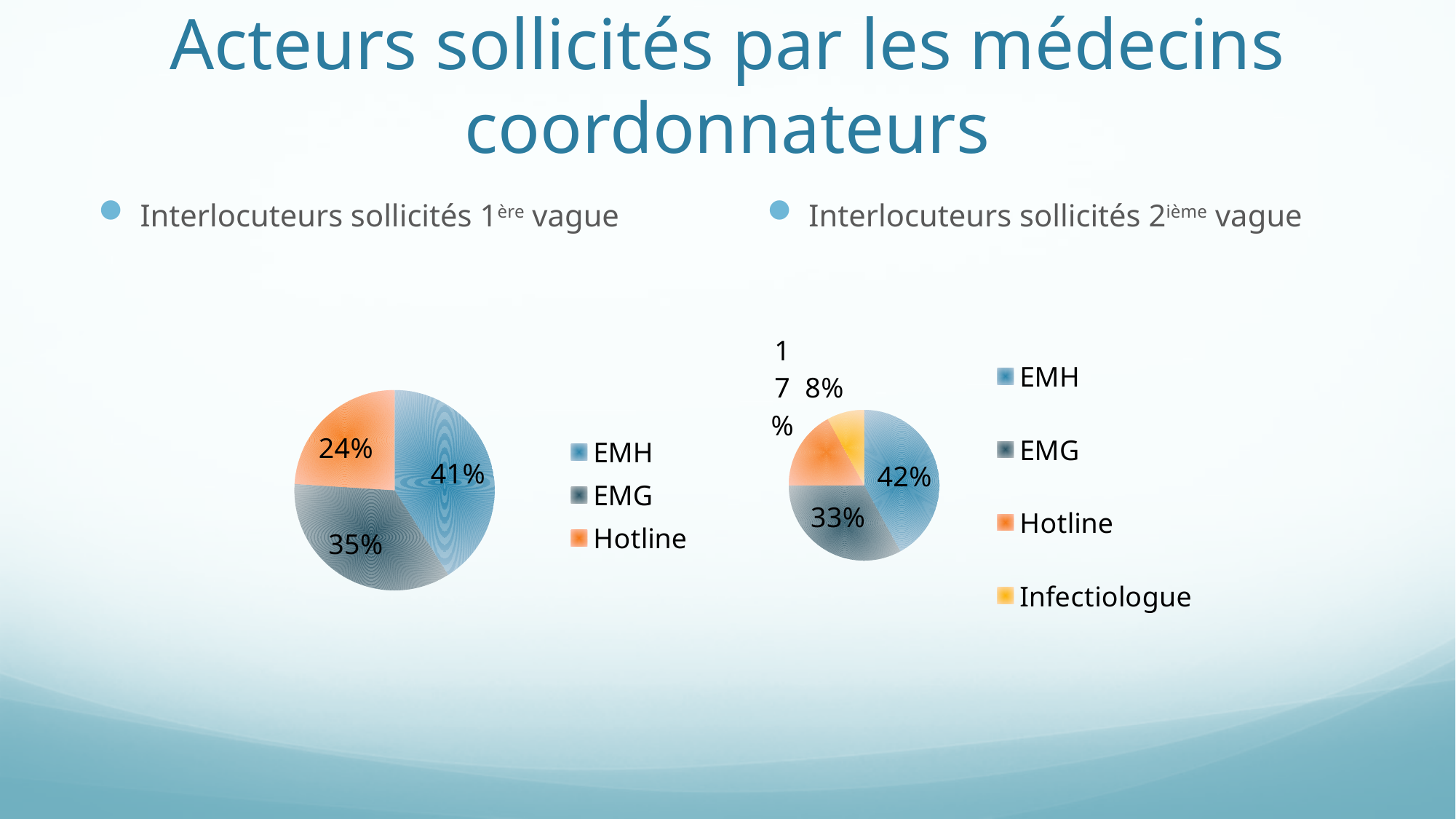
How many categories does the left pie chart (Interlocuteurs sollicités 1ère vague) show? 3 In the right pie chart (Interlocuteurs sollicités 2ième vague), what share does Infectiologue have? 8% In the right pie chart (Interlocuteurs sollicités 2ième vague), which category has the smallest share? Infectiologue In the right pie chart (Interlocuteurs sollicités 2ième vague), which is larger, the EMH share or the EMG share? EMH In the left pie chart (Interlocuteurs sollicités 1ère vague), which category has the largest share? EMH How many categories does the legend of the right pie chart (Interlocuteurs sollicités 2ième vague) list? 4 In the right pie chart (Interlocuteurs sollicités 2ième vague), what share does EMG have? 33% In the left pie chart (Interlocuteurs sollicités 1ère vague), what share does Hotline have? 24% In the left pie chart (Interlocuteurs sollicités 1ère vague), which category has the smallest share? Hotline What type of chart is used on the left side of the slide (Interlocuteurs sollicités 1ère vague)? Pie chart In the left pie chart (Interlocuteurs sollicités 1ère vague), what share does EMH have? 41% In the left pie chart (Interlocuteurs sollicités 1ère vague), what is the difference between the EMG share and the Hotline share? 11%